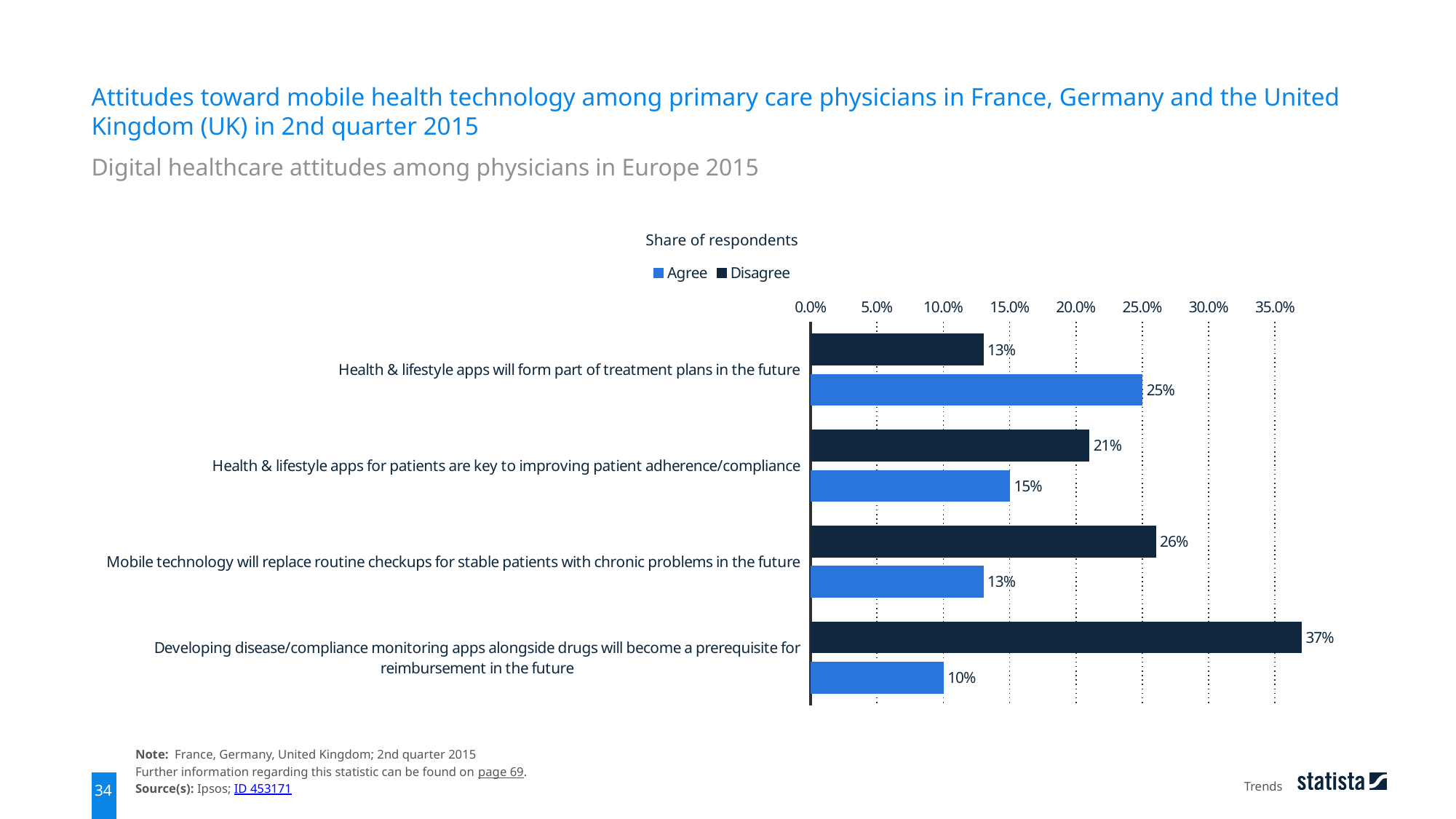
Which colour represents the Disagree series in the legend? Dark navy What type of chart is shown on the slide? Bar chart What share of respondents disagree that developing disease/compliance monitoring apps alongside drugs will become a prerequisite for reimbursement in the future? 37% What share of respondents agree that health & lifestyle apps will form part of treatment plans in the future? 25% Which statement has the lowest Agree share? Developing disease/compliance monitoring apps alongside drugs will become a prerequisite for reimbursement in the future Which statement has the highest Disagree share? Developing disease/compliance monitoring apps alongside drugs will become a prerequisite for reimbursement in the future How many series does the legend list? 2 For 'Health & lifestyle apps will form part of treatment plans in the future', is the Agree share or the Disagree share larger? Agree What is the difference between the Disagree and Agree shares for 'Developing disease/compliance monitoring apps alongside drugs will become a prerequisite for reimbursement in the future'? 27% What is the Agree value for 'Mobile technology will replace routine checkups for stable patients with chronic problems in the future'? 13% What is the Disagree value for 'Health & lifestyle apps for patients are key to improving patient adherence/compliance'? 21% How many statements are shown on the chart? 4